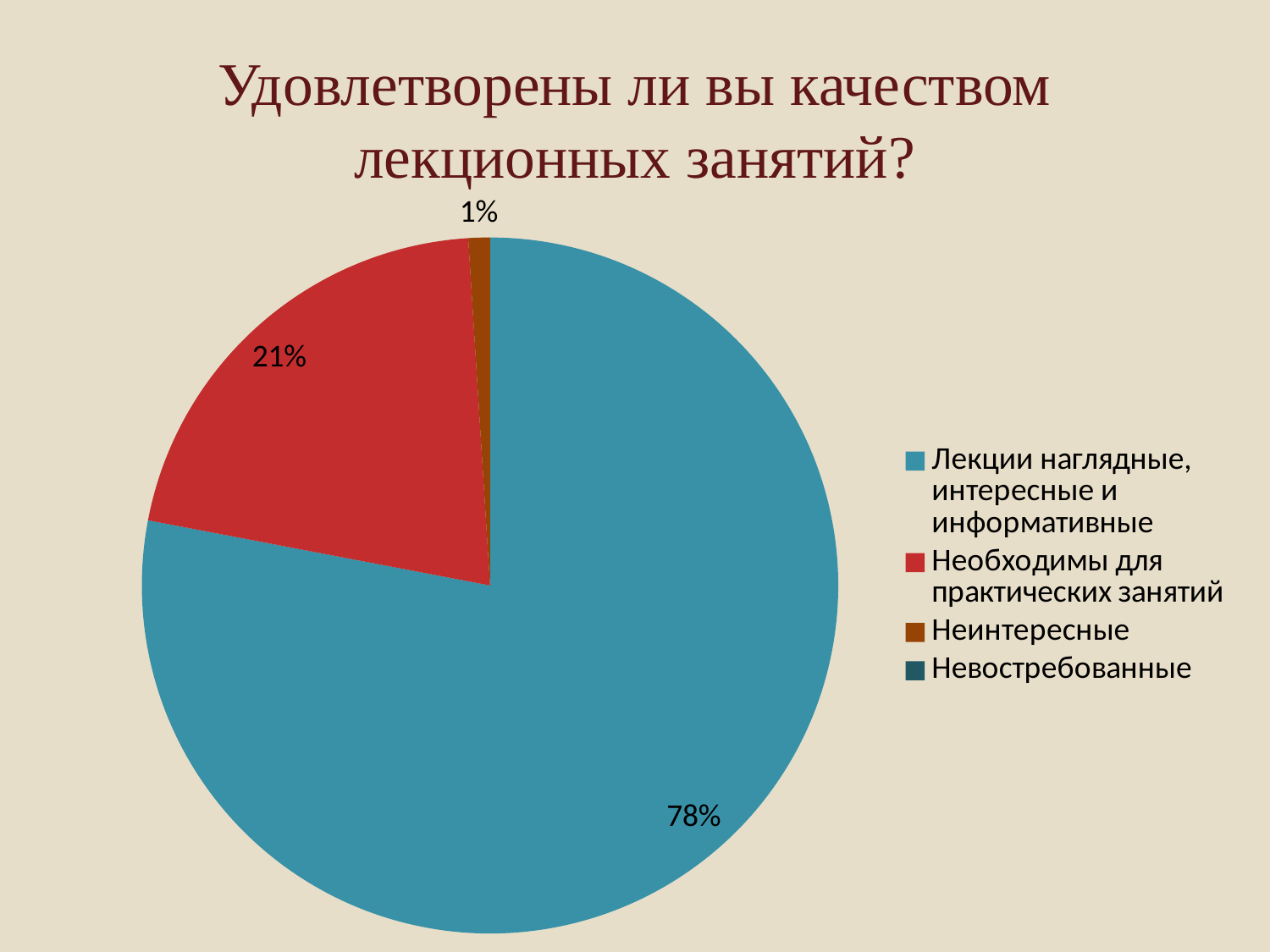
What share of the pie is labelled for "Необходимы для практических занятий"? 21% What colour is the slice for "Необходимы для практических занятий"? red What is the title of the chart? Удовлетворены ли вы качеством лекционных занятий? Is the share for "Лекции наглядные, интересные и информативные" greater or less than 50%? greater What share of the pie is labelled for "Лекции наглядные, интересные и информативные"? 78% Which slice is larger: "Необходимы для практических занятий" or "Неинтересные"? Необходимы для практических занятий What share of the pie is labelled for "Неинтересные"? 1% What is the difference in percentage points between the "Лекции наглядные, интересные и информативные" slice and the "Необходимы для практических занятий" slice? 57 What kind of chart is shown on the slide? pie chart Which of the labelled slices is the smallest? Неинтересные Which category has the largest slice of the pie? Лекции наглядные, интересные и информативные How many entries does the legend list? 4